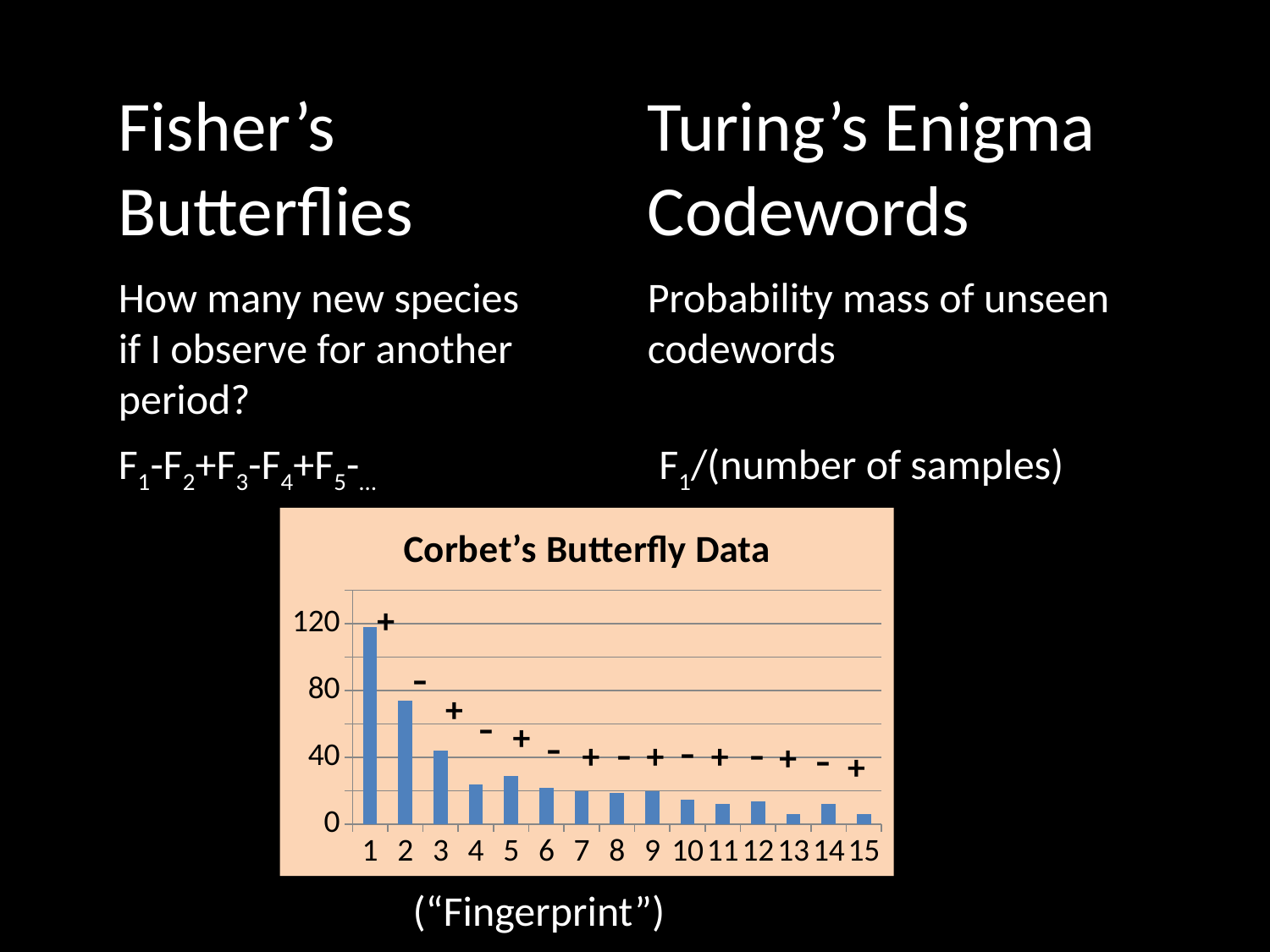
What kind of chart is shown on the slide? bar chart Do the bar values generally rise or fall as the category number increases from 1 to 15? fall Is the value for category 4 greater or less than 40? less Is the value for category 2 greater or less than 40? greater How many categories are plotted along the x axis of the chart? 15 Is the value for category 2 greater or less than 80? less Which is larger, the value for category 4 or the value for category 5? category 5 Which category has the highest bar in the chart? 1 What is the title of the chart? Corbet's Butterfly Data Which is larger, the value for category 1 or the value for category 2? category 1